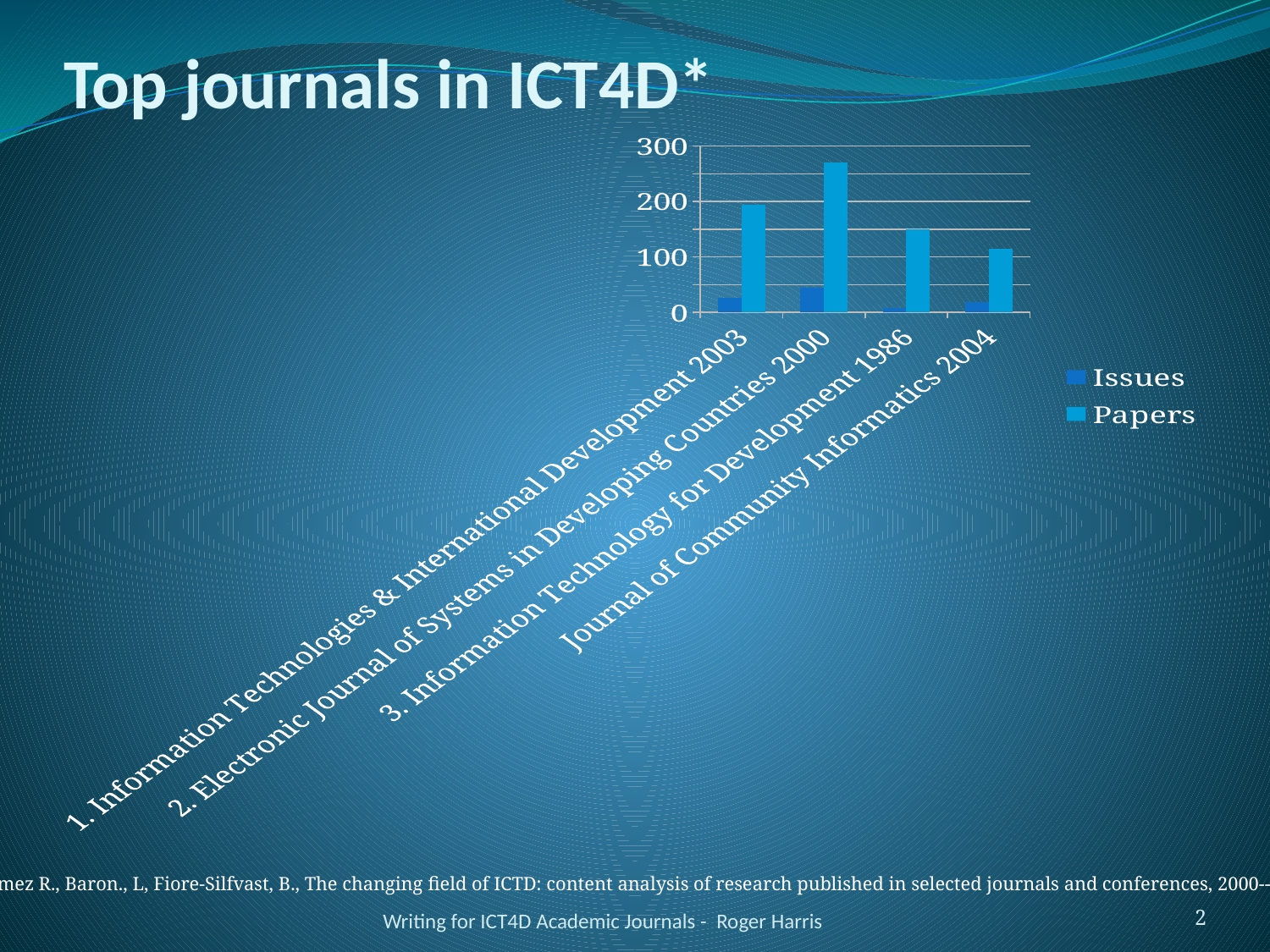
Which journal has the highest number of Issues? 2. Electronic Journal of Systems in Developing Countries 2000 Is the Papers value for 2. Electronic Journal of Systems in Developing Countries 2000 greater or less than 200? greater How many journals (categories) are plotted on the x axis of the chart? 4 Is the Papers value for 3. Information Technology for Development 1986 greater or less than 200? less Is the Issues value for 2. Electronic Journal of Systems in Developing Countries 2000 greater or less than 100? less How many series does the chart's legend list? 2 Which has more Papers: 1. Information Technologies & International Development 2003 or 3. Information Technology for Development 1986? 1. Information Technologies & International Development 2003 What are the two series named in the chart's legend? Issues and Papers Which journal has the highest number of Papers? 2. Electronic Journal of Systems in Developing Countries 2000 Which journal has the lowest number of Papers? Journal of Community Informatics 2004 What kind of chart is shown on the slide? bar chart